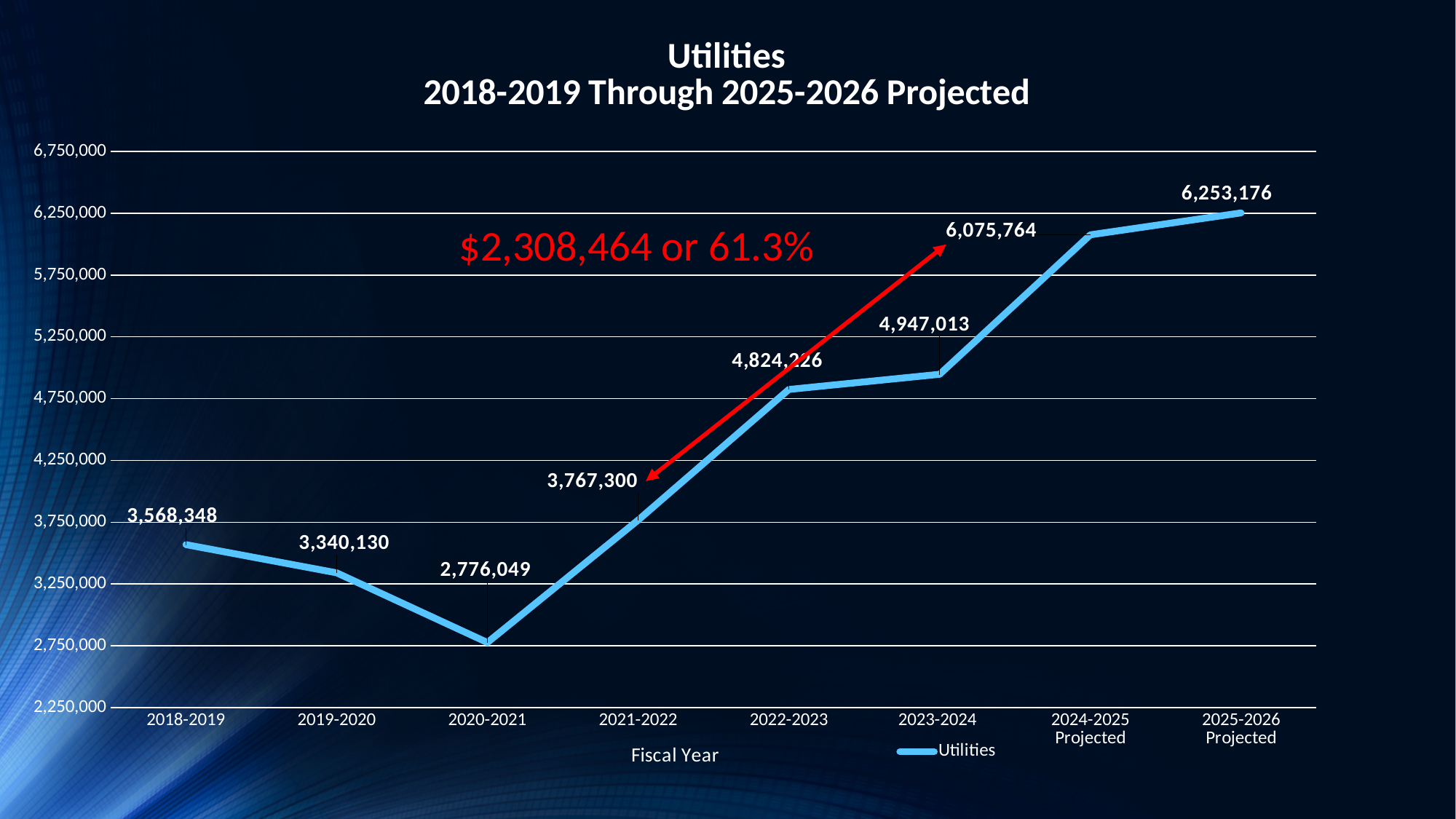
What is the Utilities value for 2024-2025 Projected? 6,075,764 What is the Utilities value for 2020-2021? 2,776,049 How many fiscal years are plotted on the chart? 8 What type of chart is shown on the slide? Line chart Which fiscal year has the highest Utilities value? 2025-2026 Projected Which is larger, the Utilities value for 2019-2020 or for 2021-2022? 2021-2022 What is the difference between the Utilities values for 2021-2022 and 2020-2021? 991,251 Which fiscal year has the lowest Utilities value? 2020-2021 What is the difference between the Utilities values for 2025-2026 Projected and 2018-2019? 2,684,828 What increase does the red annotation on the chart state? $2,308,464 or 61.3% What is the Utilities value for 2025-2026 Projected? 6,253,176 What is the Utilities value for 2018-2019? 3,568,348